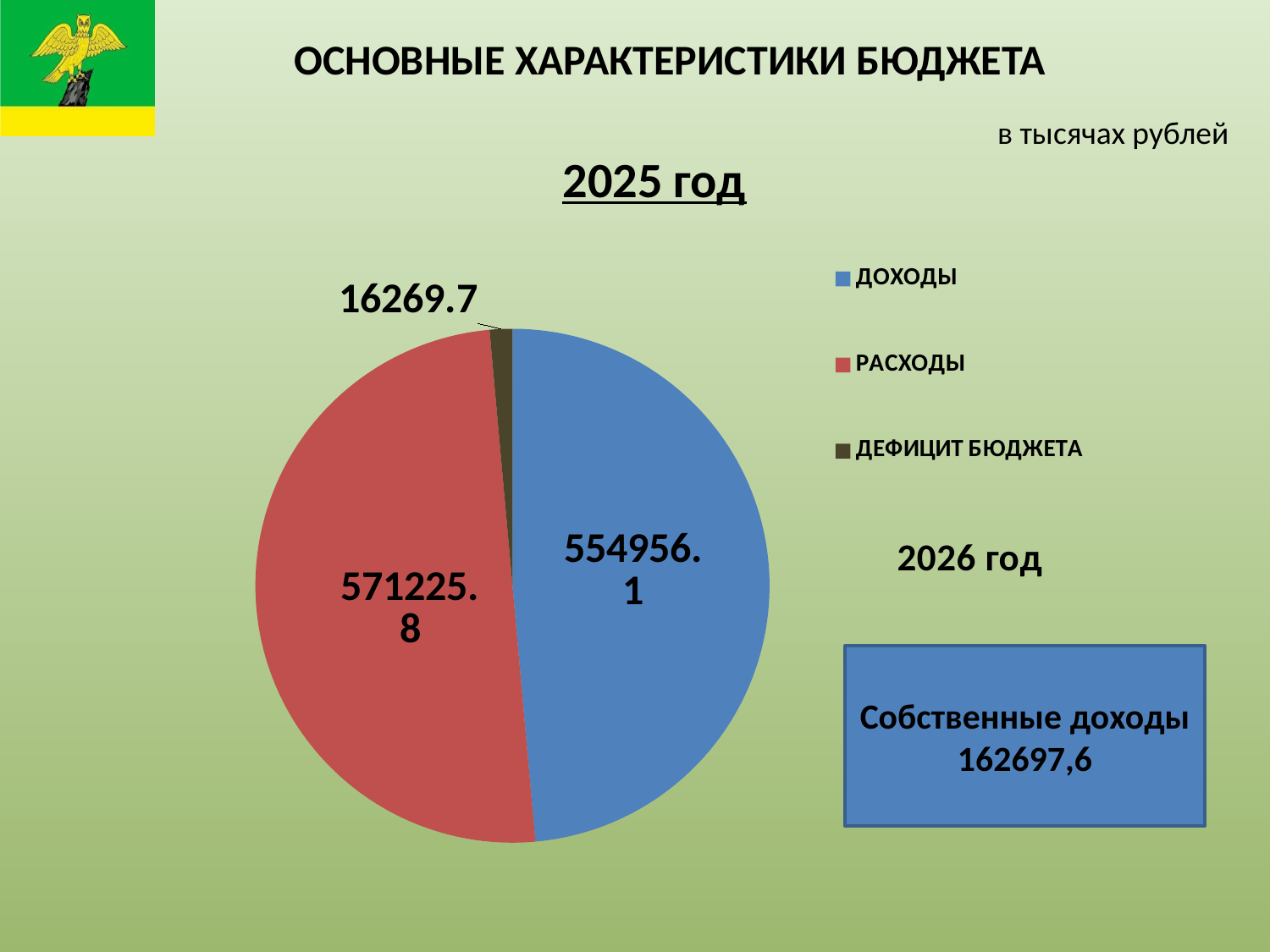
What is the difference between the РАСХОДЫ and ДОХОДЫ values in the pie chart? 16269.7 Which category has the largest slice in the pie chart? РАСХОДЫ What year is the pie chart labelled with? 2025 год What colour is the ДОХОДЫ slice in the pie chart? Blue What is the value of the ДОХОДЫ slice in the pie chart? 554956.1 What is the value of the РАСХОДЫ slice in the pie chart? 571225.8 Which is larger in the pie chart, ДОХОДЫ or РАСХОДЫ? РАСХОДЫ What type of chart is shown on the slide? Pie chart How many entries does the legend of the pie chart list? 3 What is the value of the ДЕФИЦИТ БЮДЖЕТА slice in the pie chart? 16269.7 Which category has the smallest slice in the pie chart? ДЕФИЦИТ БЮДЖЕТА How many slices does the pie chart have? 3